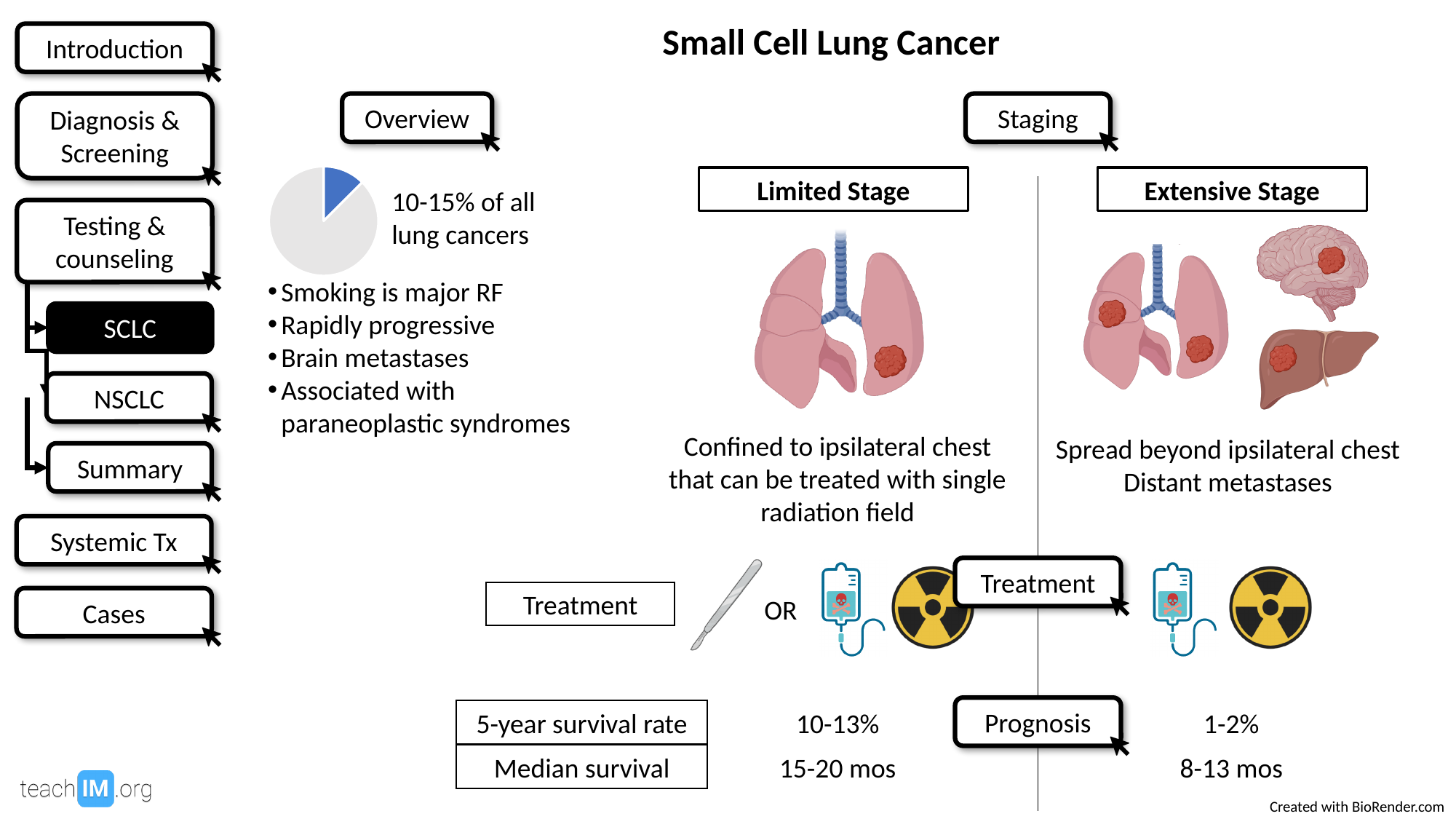
Is the share of all lung cancers represented by the blue slice of the pie chart greater or less than 50%? less In the pie chart, which slice is larger: the blue slice or the grey slice? the grey slice According to the text next to the pie chart, what share of all lung cancers does the highlighted slice represent? 10-15% What colour is the pie slice representing small cell lung cancer's share of all lung cancers? blue What kind of chart is shown in the Overview section of the slide? pie chart How many slices does the pie chart in the Overview section have? 2 Does the pie chart in the Overview section have a legend? No